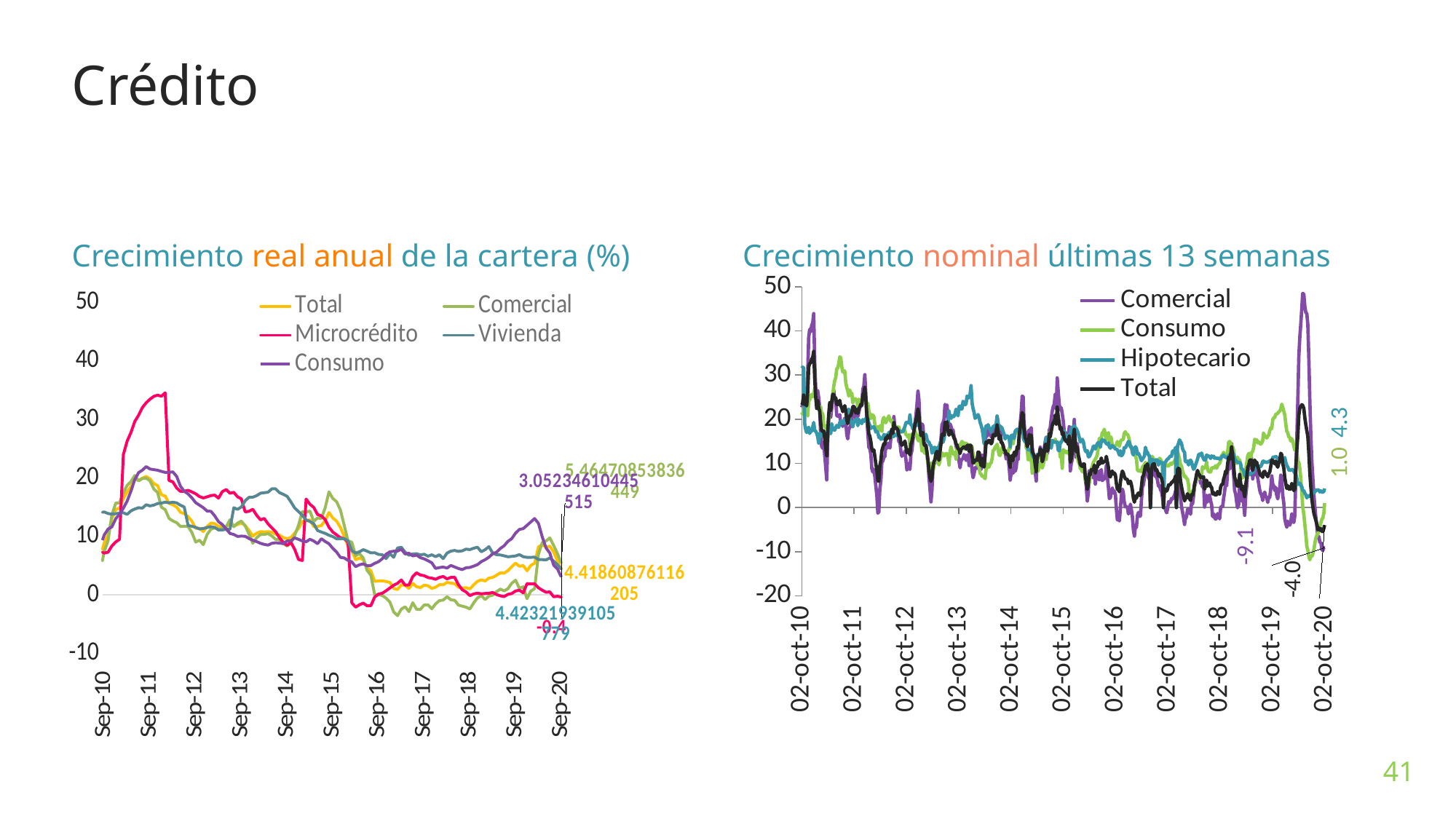
In the right chart, 'Crecimiento nominal últimas 13 semanas', what is the final labelled value for Comercial? -9.1 In the left chart, 'Crecimiento real anual de la cartera (%)', does the Microcrédito series rise or fall from its peak around Sep-11 to Sep-20? fall In the right chart, 'Crecimiento nominal últimas 13 semanas', which series has the lowest final labelled value? Comercial How many series does the legend of the right chart, 'Crecimiento nominal últimas 13 semanas', list? 4 In the right chart, 'Crecimiento nominal últimas 13 semanas', what is the final labelled value for Hipotecario? 4.3 In the right chart, 'Crecimiento nominal últimas 13 semanas', what is the difference between the final labelled values of Hipotecario and Consumo? 3.3 In the right chart, 'Crecimiento nominal últimas 13 semanas', which series has the highest final labelled value? Hipotecario How many series does the legend of the left chart, 'Crecimiento real anual de la cartera (%)', list? 5 In the right chart, 'Crecimiento nominal últimas 13 semanas', what is the final labelled value for Consumo? 1.0 What kind of chart is the left chart, 'Crecimiento real anual de la cartera (%)'? line chart In the left chart, 'Crecimiento real anual de la cartera (%)', is the peak of the Microcrédito series around Sep-11 greater or less than 30? greater In the right chart, 'Crecimiento nominal últimas 13 semanas', what is the final labelled value for Total? -4.0